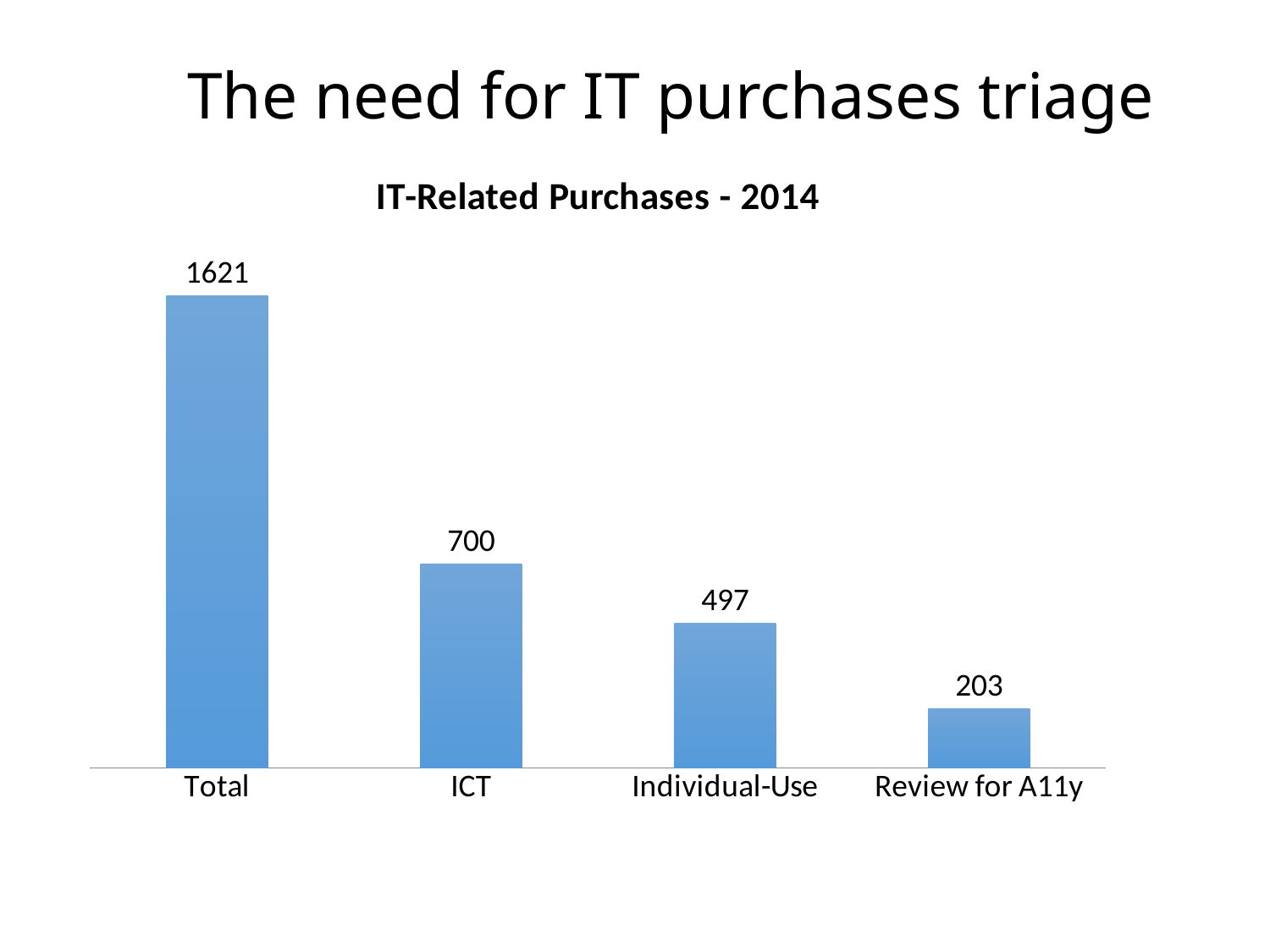
What is the value for Review for A11y? 203 Which category has the highest value? Total Which is larger, the value for Individual-Use or the value for Review for A11y? Individual-Use What is the difference between the values for Total and ICT? 921 What is the value for Total? 1621 How many categories are shown in the chart? 4 What kind of chart is shown on the slide? Bar chart What is the value for Individual-Use? 497 What is the difference between the values for ICT and Individual-Use? 203 Which category has the lowest value? Review for A11y What is the title of the chart? IT-Related Purchases - 2014 What is the value for ICT? 700